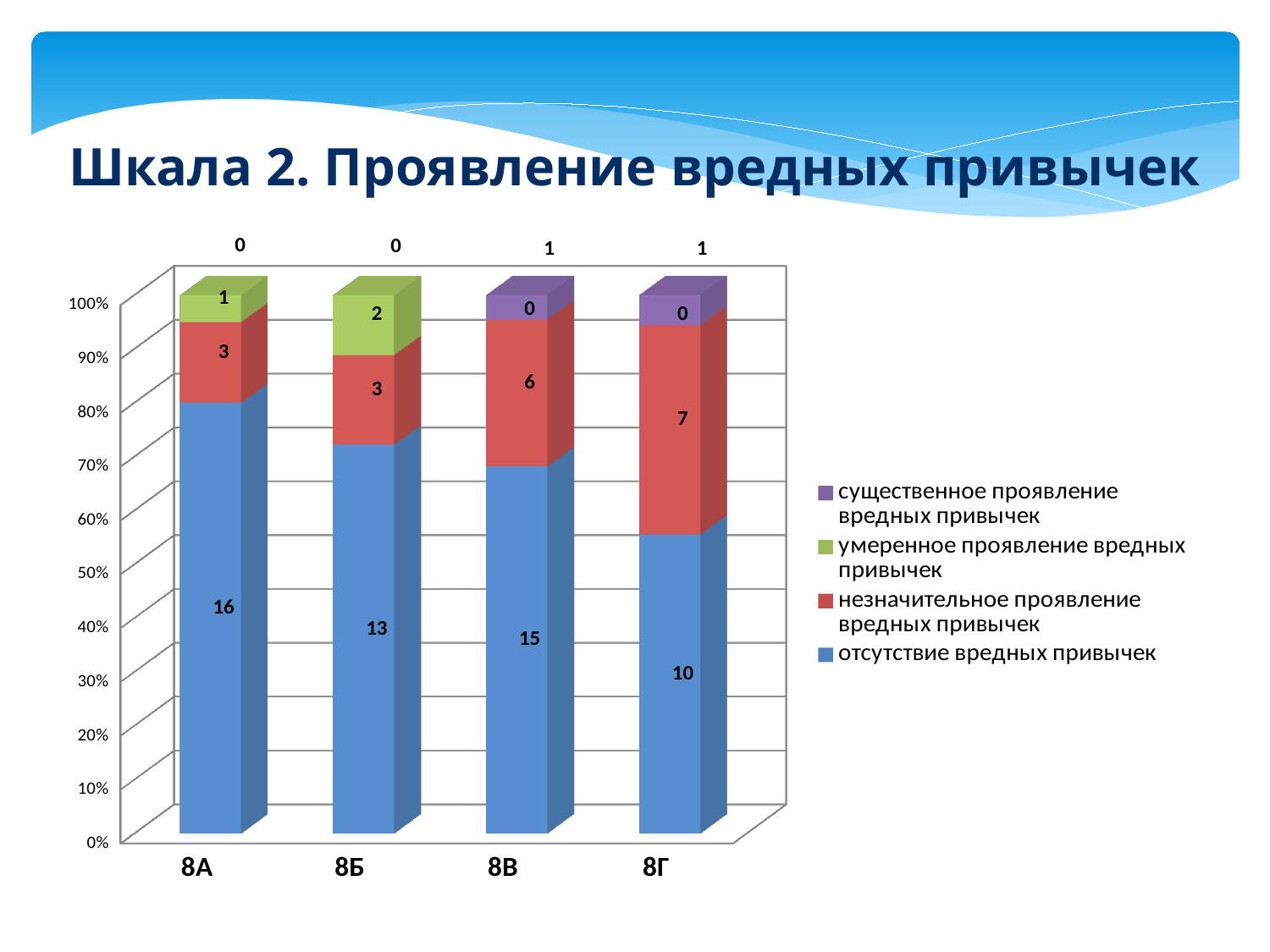
What is the value for 'незначительное проявление вредных привычек' in class 8Г? 7 What is the value for 'отсутствие вредных привычек' in class 8А? 16 How many categories (classes) are shown on the x axis? 4 What is the value for 'существенное проявление вредных привычек' in class 8В? 1 What is the total of all segments in the bar for class 8В? 22 Which class has the highest value for 'отсутствие вредных привычек'? 8А What is the chart's title? Шкала 2. Проявление вредных привычек Which class has the lowest value for 'отсутствие вредных привычек'? 8Г What is the difference between the 'незначительное проявление вредных привычек' values for 8Г and 8А? 4 What kind of chart is shown on the slide? stacked bar chart How many series does the legend list? 4 What is the value for 'умеренное проявление вредных привычек' in class 8Б? 2